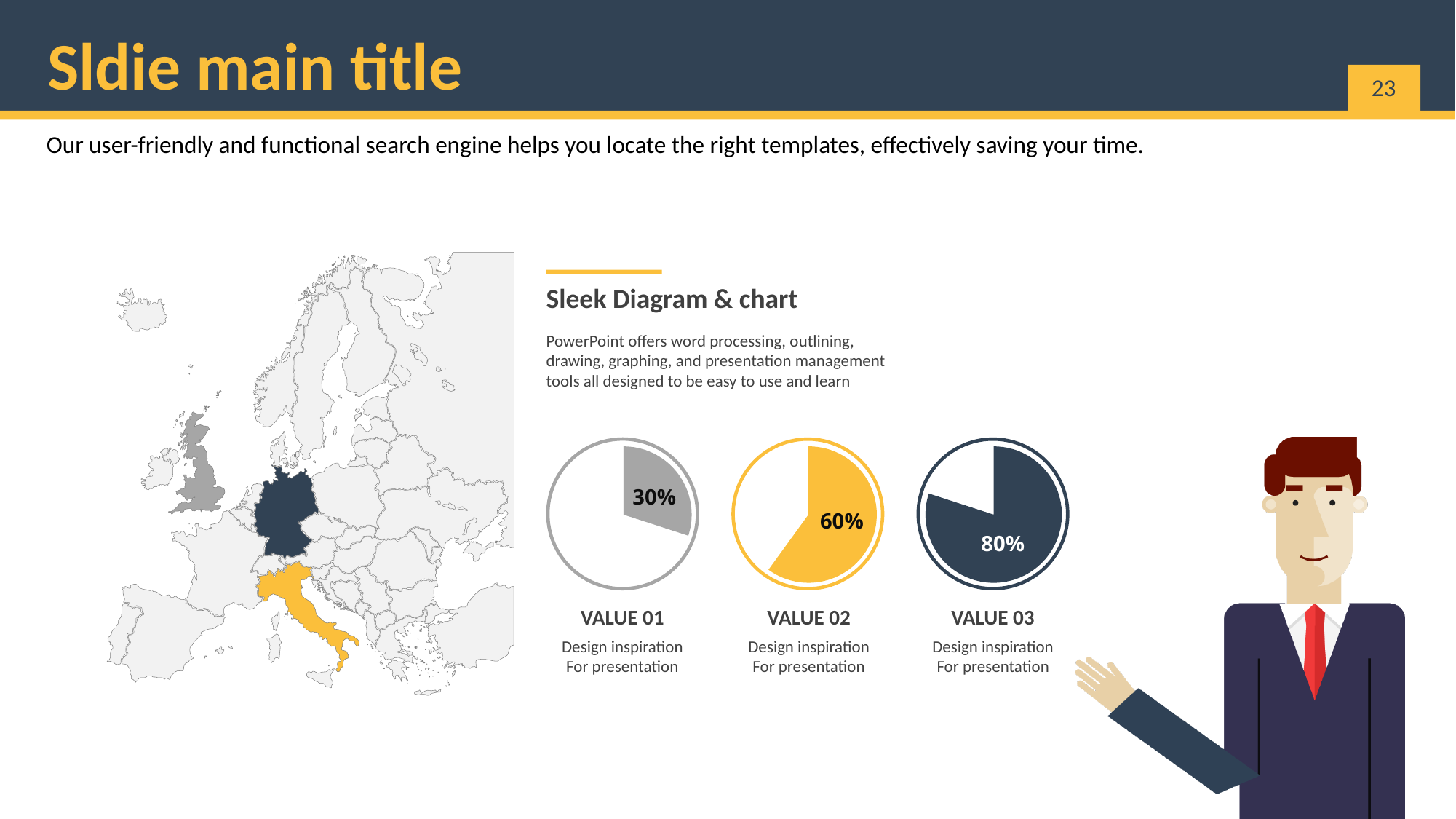
What kind of chart is used to display VALUE 01, VALUE 02 and VALUE 03? Pie chart What percentage is shown in the pie chart labelled VALUE 01? 30% What is the difference between the percentage shown for VALUE 03 and the percentage shown for VALUE 01? 50% What percentage is shown in the pie chart labelled VALUE 02? 60% What is the heading printed above the three pie charts? Sleek Diagram & chart What percentage is shown in the pie chart labelled VALUE 03? 80% What is the difference between the percentage shown for VALUE 02 and the percentage shown for VALUE 01? 30% How many pie charts are shown on the slide? 3 What colour is the filled slice in the VALUE 02 pie chart? Yellow Which of the three pie charts (VALUE 01, VALUE 02, VALUE 03) shows the lowest percentage? VALUE 01 Which shows a larger percentage, the VALUE 02 pie chart or the VALUE 03 pie chart? VALUE 03 Which of the three pie charts (VALUE 01, VALUE 02, VALUE 03) shows the highest percentage? VALUE 03